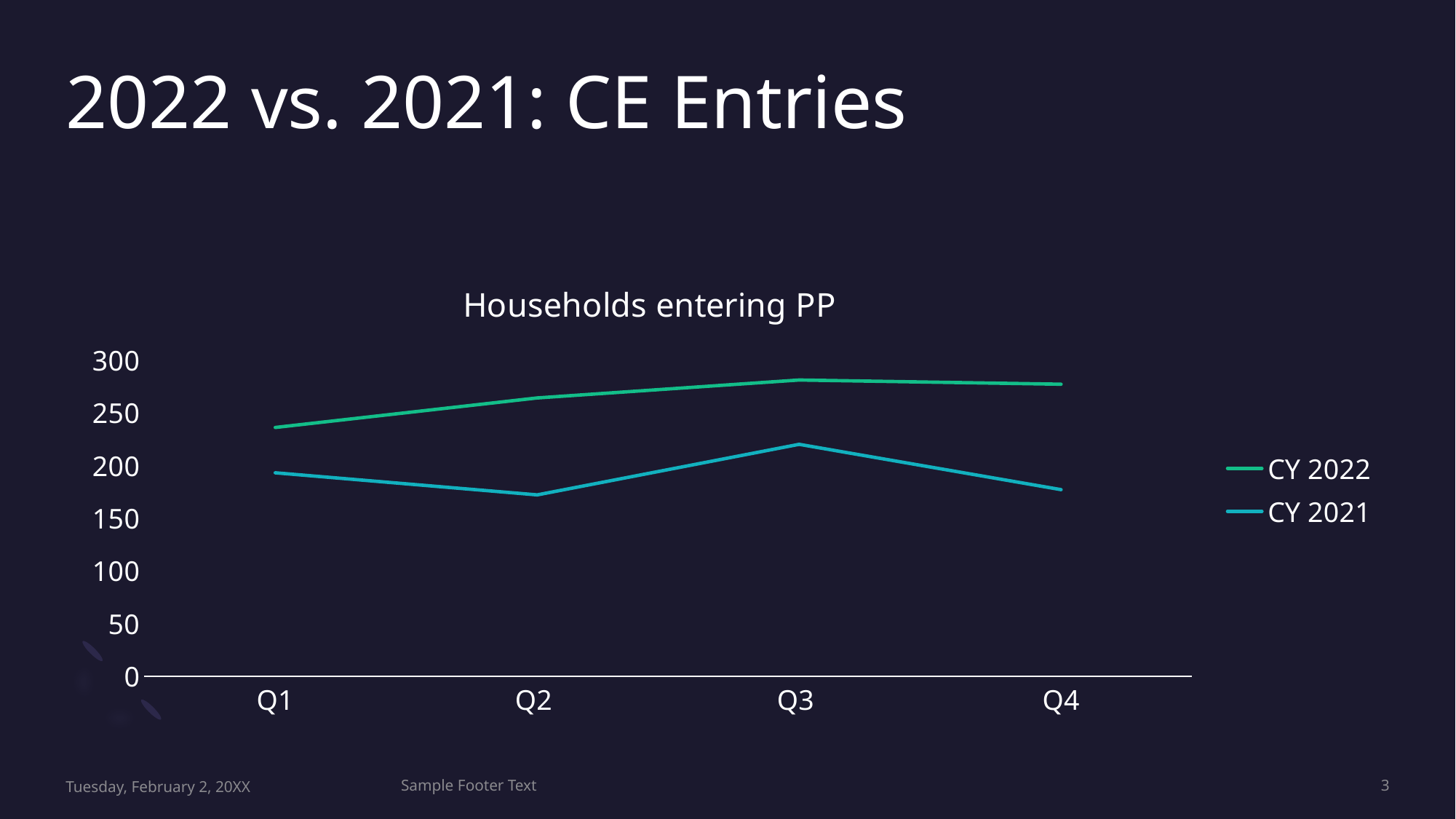
In which quarter does the CY 2021 line reach its highest value? Q3 How many series does the legend list? 2 Is the CY 2022 value for Q2 greater or less than 250? greater Which series has the larger value in Q4, CY 2022 or CY 2021? CY 2022 Is the CY 2022 value for Q3 greater or less than 300? less Is the CY 2021 value for Q3 greater or less than 200? greater What is the title of the chart? Households entering PP What kind of chart is shown on the slide? line chart In which quarter does the CY 2022 line have its lowest value? Q1 How many quarters are plotted along the x axis? 4